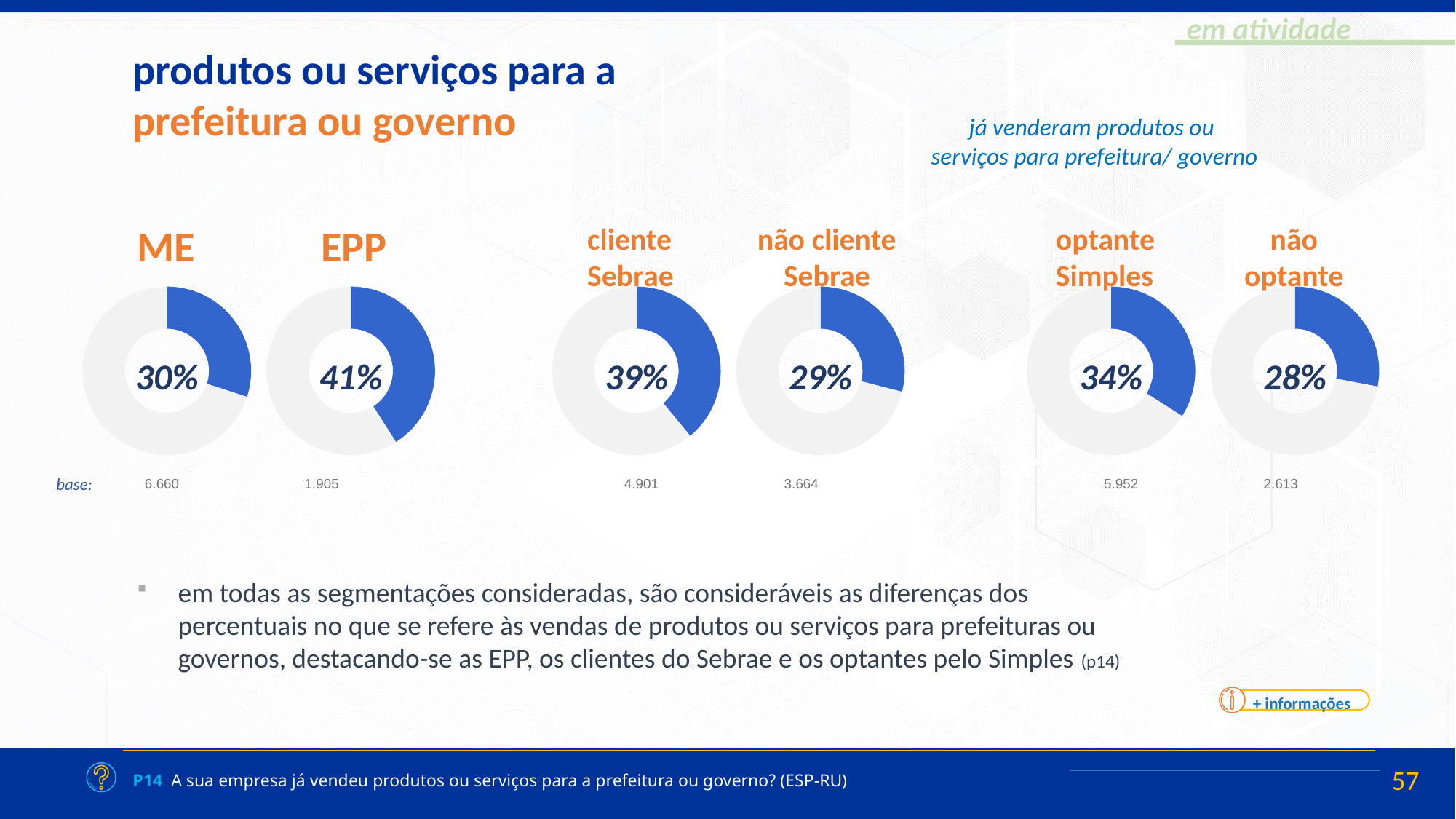
How many donut charts are shown on the slide? 6 What percentage is shown in the 'não cliente Sebrae' donut chart? 29% What percentage is shown in the 'não optante' donut chart? 28% Which of the six donut charts shows the lowest percentage? não optante Which shows a higher percentage, the 'cliente Sebrae' chart or the 'não cliente Sebrae' chart? cliente Sebrae What percentage is shown in the 'cliente Sebrae' donut chart? 39% What percentage is shown in the EPP donut chart? 41% What percentage is shown in the 'optante Simples' donut chart? 34% Which of the six donut charts shows the highest percentage? EPP What is the difference in percentage points between the EPP and ME donut charts? 11 What percentage is shown in the ME donut chart? 30% What kind of chart is used to display the percentages on the slide? Donut (pie) chart